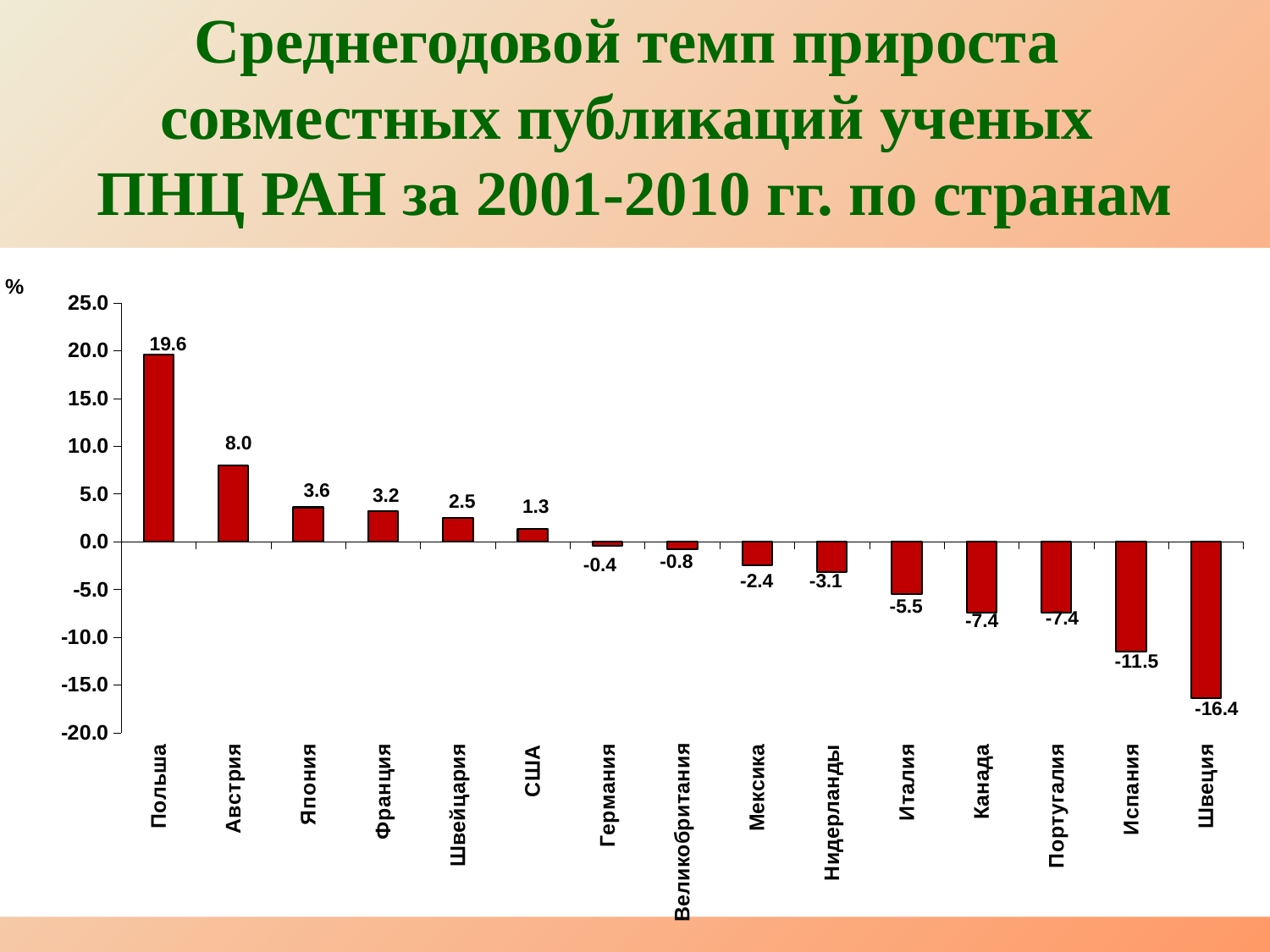
What is the value for Польша? 19.6 Which country has the highest value? Польша How many countries are shown on the chart? 15 What kind of chart is shown on the slide? bar chart Is the value for Испания greater or less than -10.0? less What is the difference between the values for Польша and Австрия? 11.6 What unit is shown on the vertical axis label? % Do the values rise or fall from left to right along the x axis? fall Which country has the lowest value? Швеция What is the value for Швеция? -16.4 Which has a larger value, Япония or Франция? Япония What is the value for Италия? -5.5